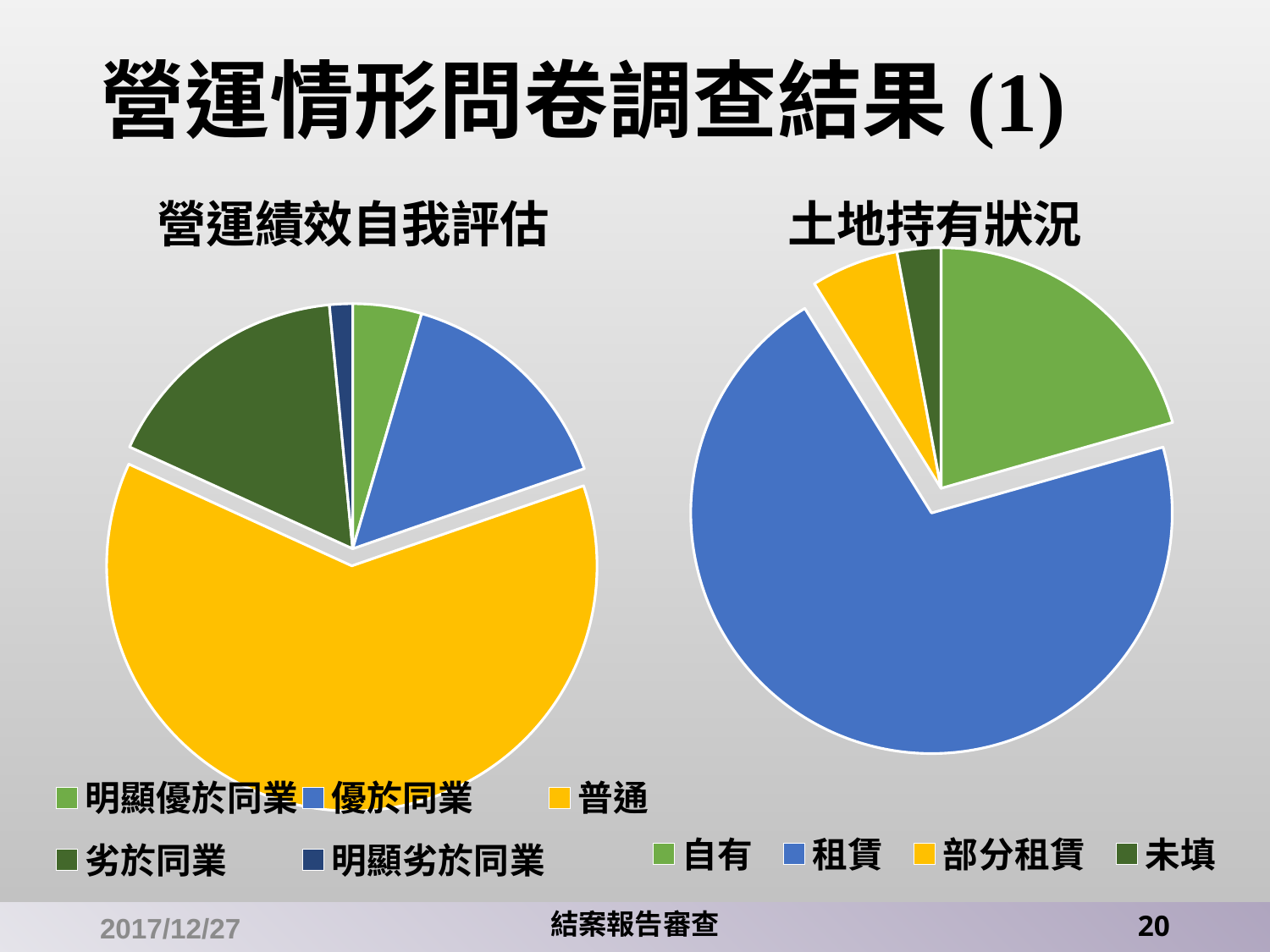
What is the title of the pie chart on the left of the slide? 營運績效自我評估 In the 土地持有狀況 chart, which category has the largest slice? 租賃 In the 營運績效自我評估 chart, which category has the largest slice? 普通 In the 土地持有狀況 chart, what colour is the 租賃 slice? blue In the 營運績效自我評估 chart, which category has the smallest slice? 明顯劣於同業 In the 土地持有狀況 chart, which category has the smallest slice? 未填 In the 營運績效自我評估 chart, how many categories does the legend list? 5 In the 土地持有狀況 chart, how many categories does the legend list? 4 What kind of chart is the 營運績效自我評估 chart on the left? pie chart In the 土地持有狀況 chart, which slice is larger: 自有 or 部分租賃? 自有 What kind of chart is the 土地持有狀況 chart on the right? pie chart In the 營運績效自我評估 chart, which slice is larger: 劣於同業 or 明顯優於同業? 劣於同業